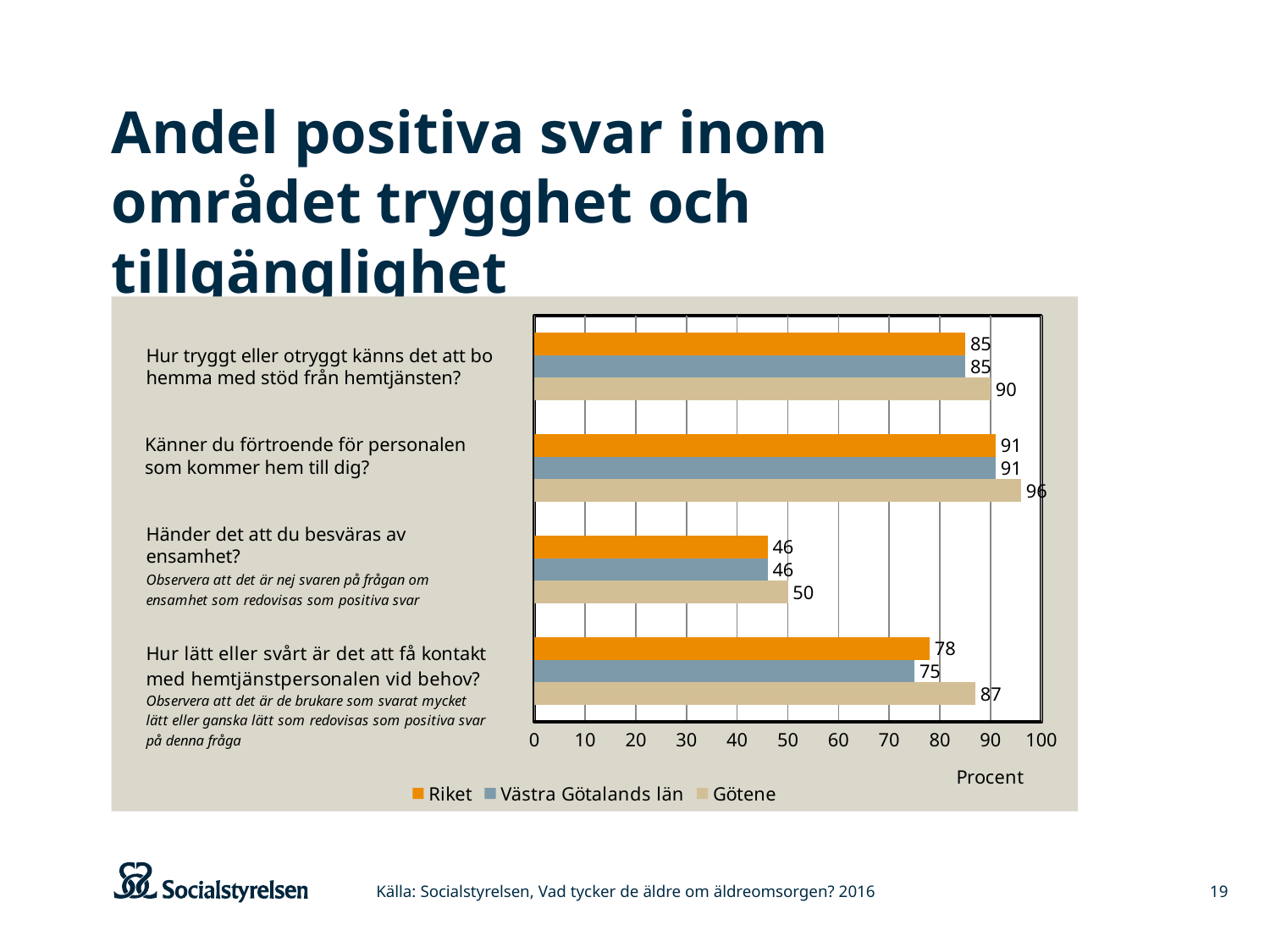
What is the value for Riket on the question "Hur lätt eller svårt är det att få kontakt med hemtjänstpersonalen vid behov?"? 78 What kind of chart is shown on the slide? Bar chart What is the value for Götene on the question "Hur tryggt eller otryggt känns det att bo hemma med stöd från hemtjänsten?"? 90 What is the value for Västra Götalands län on the question "Händer det att du besväras av ensamhet?"? 46 Which question has the highest value for Riket? Känner du förtroende för personalen som kommer hem till dig? Which question has the lowest value for Götene? Händer det att du besväras av ensamhet? Is the value for Västra Götalands län on the question "Hur lätt eller svårt är det att få kontakt med hemtjänstpersonalen vid behov?" greater or less than 80? less How many series does the legend list? 3 How many questions (categories) are shown on the chart? 4 What is the value for Götene on the question "Känner du förtroende för personalen som kommer hem till dig?"? 96 On the question "Händer det att du besväras av ensamhet?", which is larger: the value for Götene or the value for Riket? Götene What is the difference between Götene and Västra Götalands län on the question "Hur lätt eller svårt är det att få kontakt med hemtjänstpersonalen vid behov?"? 12